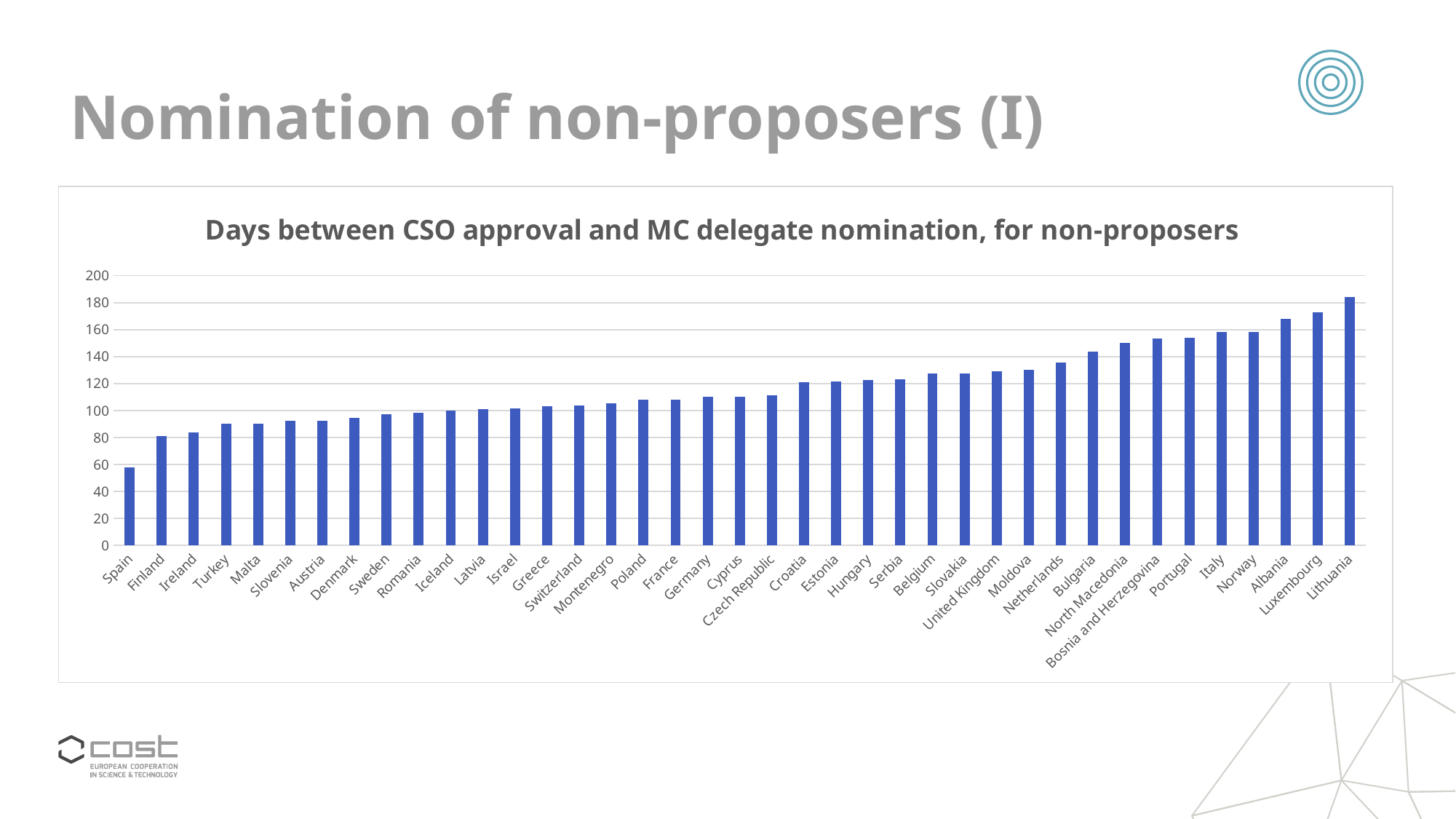
Which country has the lowest value in the chart? Spain Is the value for Netherlands greater or less than 140? less How many countries are shown on the x axis of the chart? 39 Is the value for Spain greater or less than 80? less Is the value for Lithuania greater or less than 180? greater Do the values rise or fall moving from left to right along the x axis? rise What kind of chart is shown on the slide? bar chart What is the title of the chart? Days between CSO approval and MC delegate nomination, for non-proposers Which has the larger value, Portugal or Poland? Portugal Which country has the highest value in the chart? Lithuania